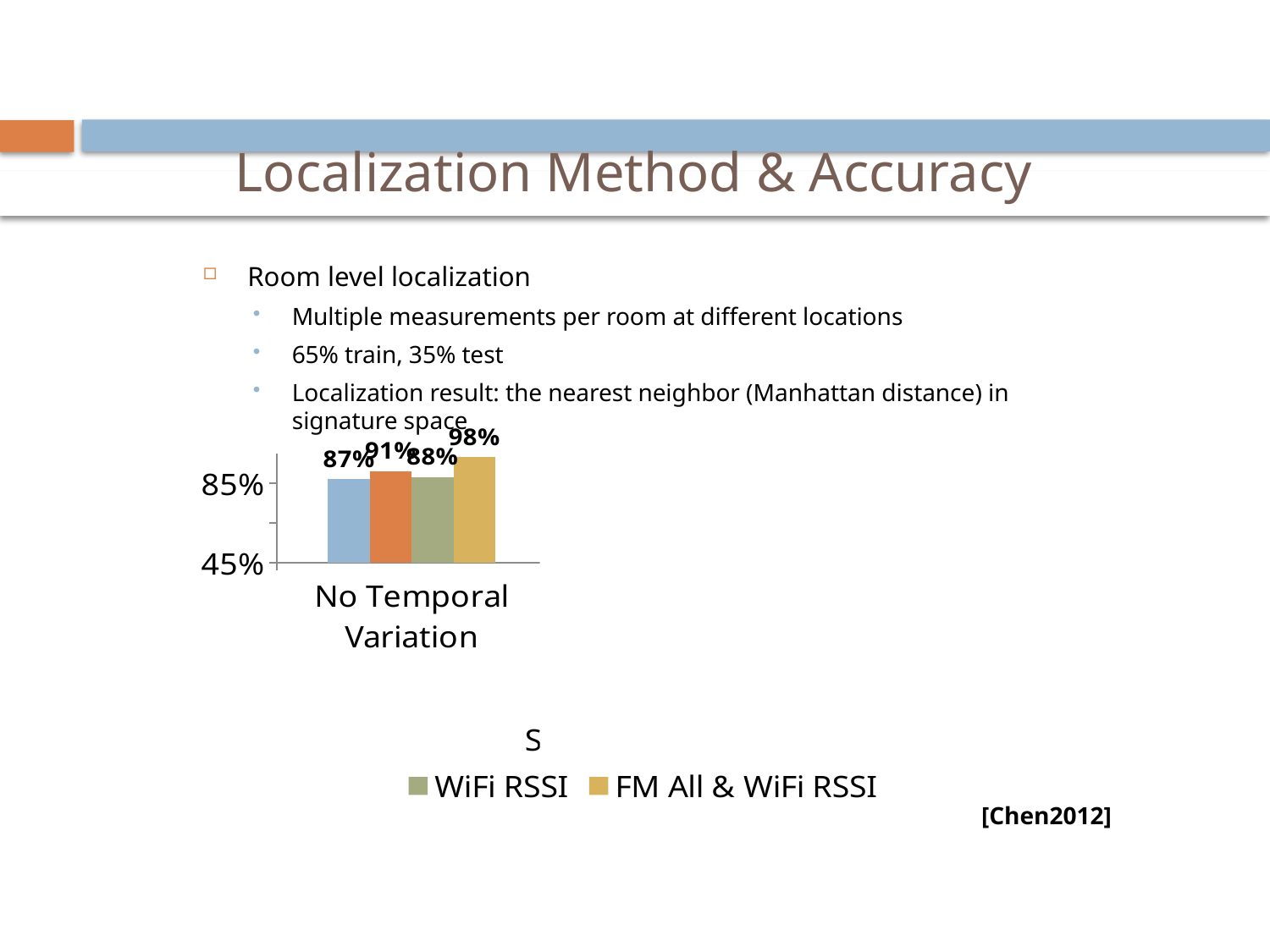
What is the value for FM All & WiFi RSSI in the chart? 98% Is the value for WiFi RSSI greater or less than 85%? greater What is the category label on the x axis of the chart? No Temporal Variation How many categories are shown on the x axis of the chart? 1 What kind of chart is shown on the slide? bar chart Which is larger, the value for WiFi RSSI or the value for FM All & WiFi RSSI? FM All & WiFi RSSI Which series has the highest value in the chart? FM All & WiFi RSSI What is the lowest value shown in the chart? 87% How many bars are plotted in the chart? 4 What is the difference between the FM All & WiFi RSSI value and the WiFi RSSI value? 10% What is the highest value shown in the chart? 98% What is the value for WiFi RSSI in the chart? 88%